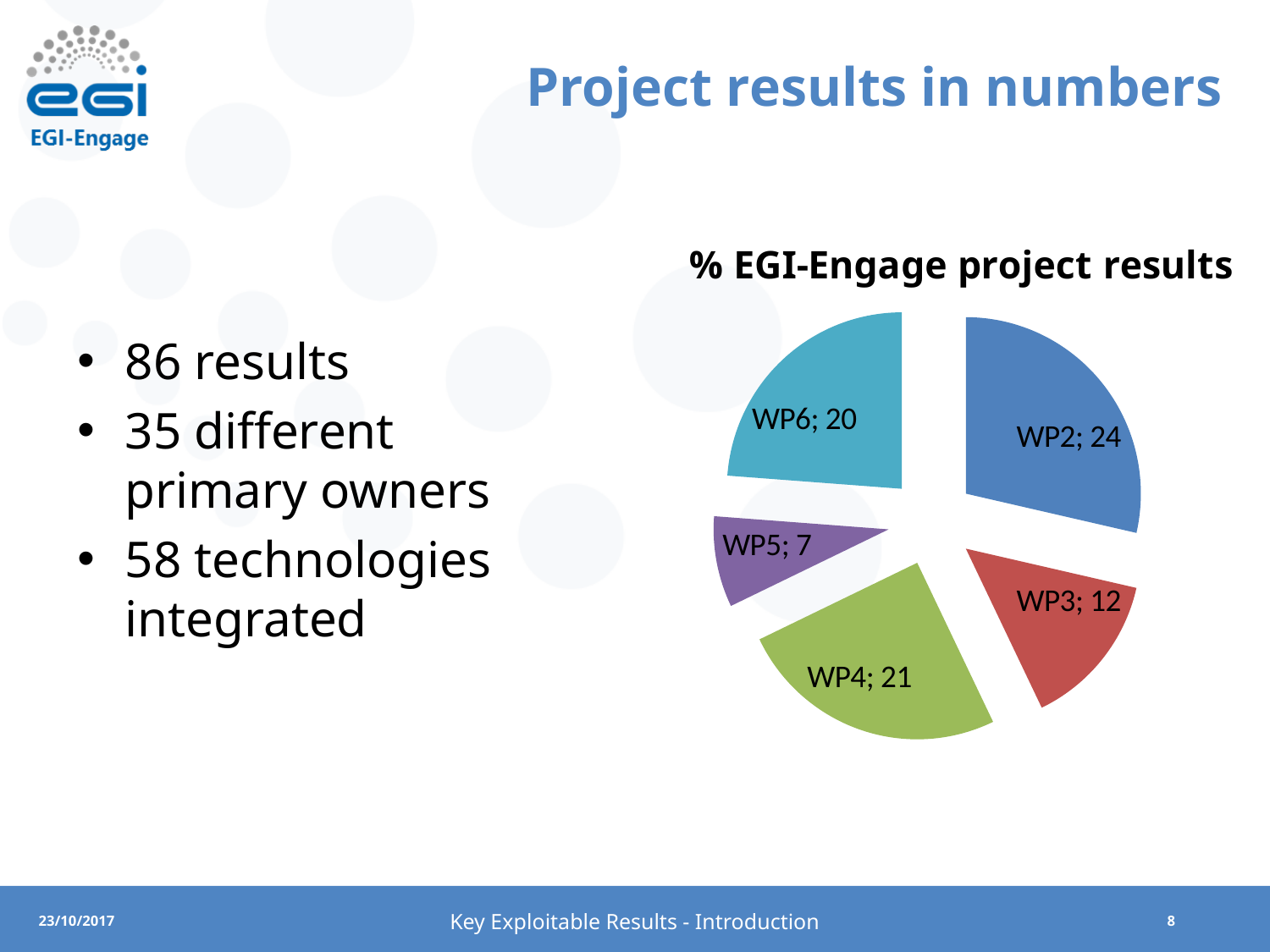
What is the title of the chart? % EGI-Engage project results Which has a larger value, WP4 or WP6? WP4 What is the difference between the values for WP2 and WP3? 12 Which work package has the largest slice of the pie? WP2 How many slices does the pie chart have? 5 Which work package has the smallest slice of the pie? WP5 What type of chart is shown on the slide? pie chart What is the value shown for WP4? 21 What is the value shown for WP3? 12 What is the value shown for WP5? 7 What is the value shown for WP2? 24 What is the value shown for WP6? 20